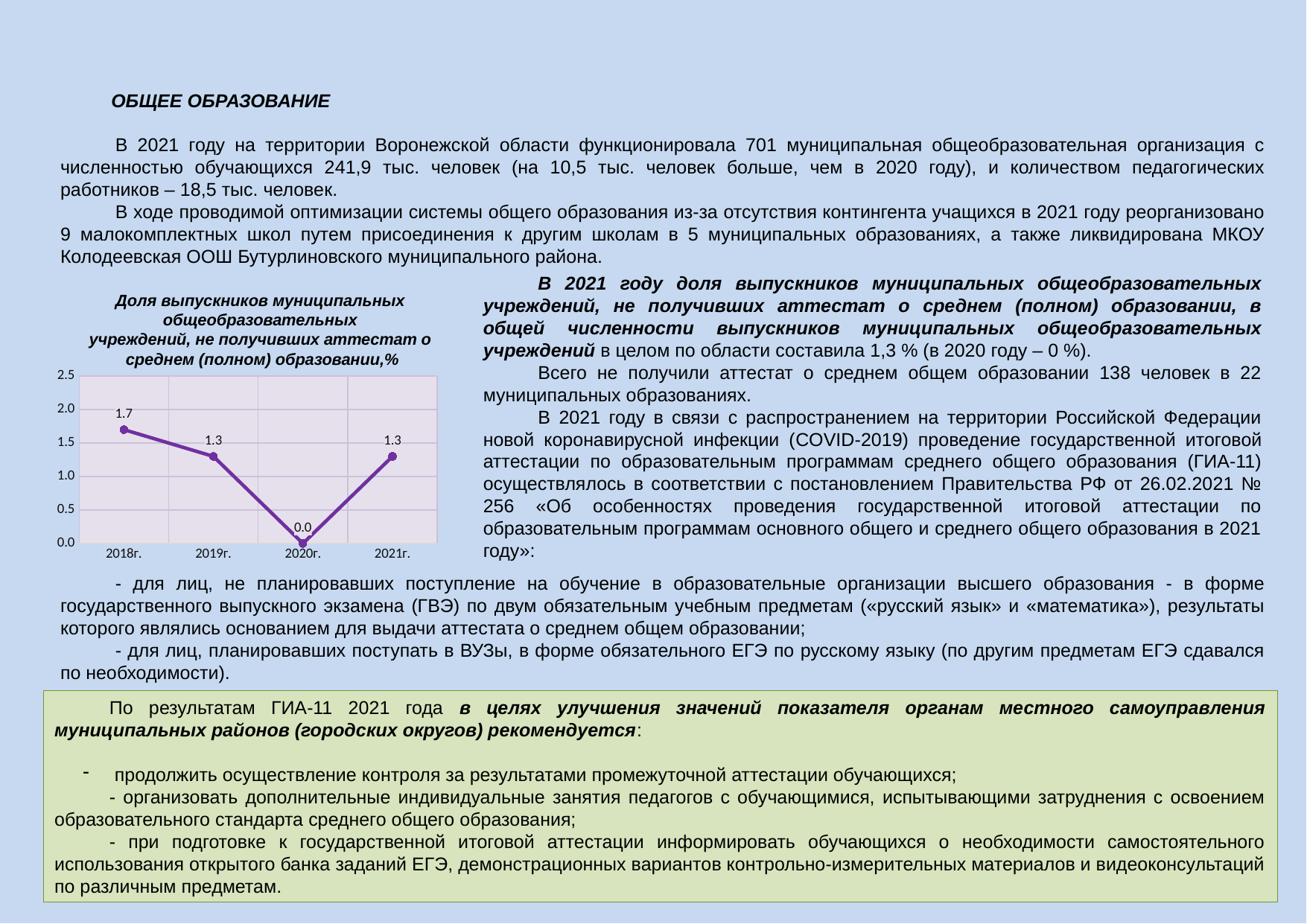
What is the value for 2019г. in the chart? 1.3 Does the value rise or fall from 2020г. to 2021г.? rise What is the value for 2021г. in the chart? 1.3 Which year has the highest value in the chart? 2018г. What is the value for 2018г. in the chart? 1.7 How many years are plotted on the x axis of the chart? 4 What is the difference between the values for 2018г. and 2019г.? 0.4 Is the value for 2018г. greater or less than 1.5? greater What is the value for 2020г. in the chart? 0.0 Which year has the lowest value in the chart? 2020г. What type of chart is shown on the slide? line chart Which is larger, the value for 2018г. or the value for 2021г.? 2018г.